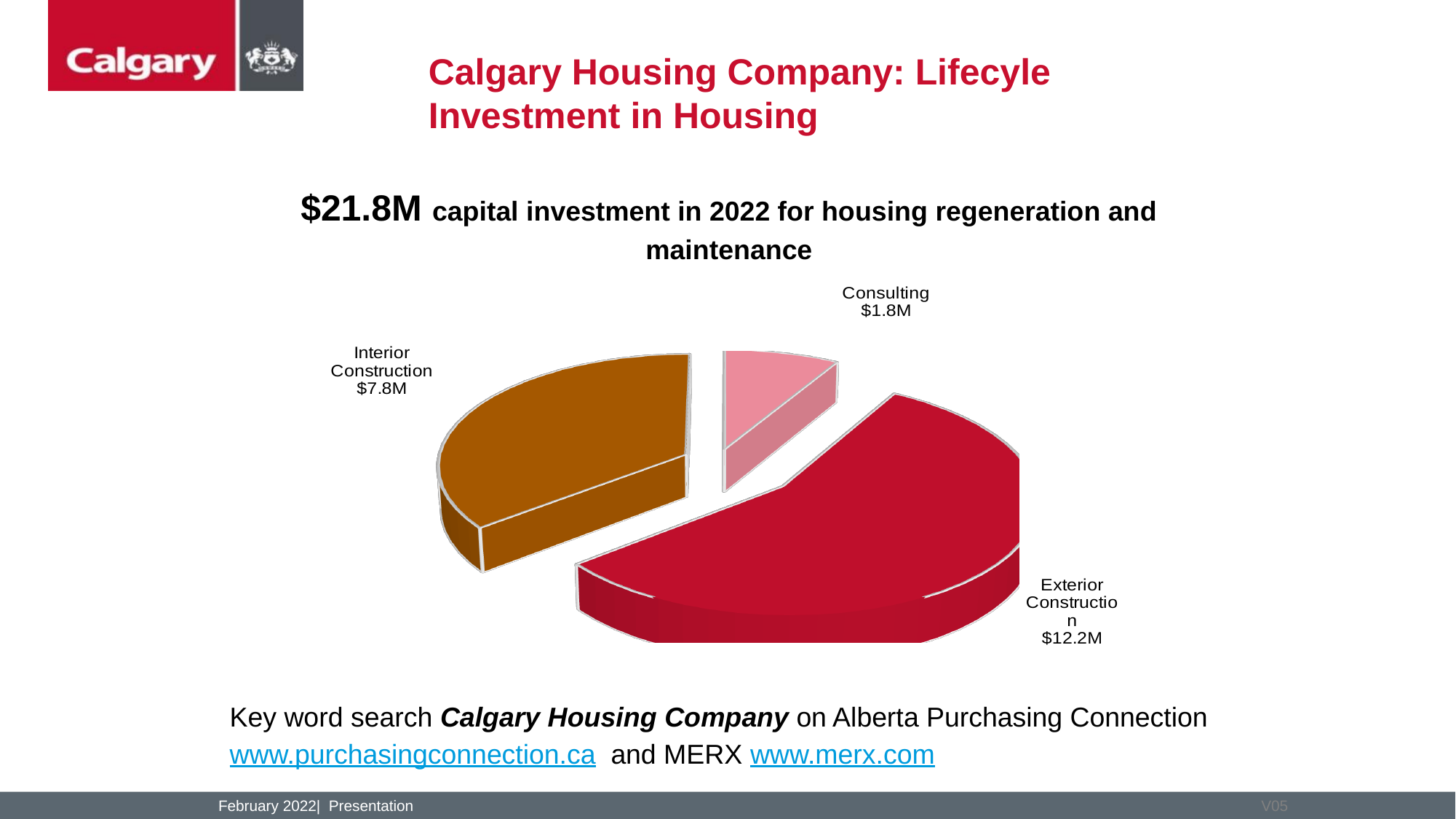
What is the total capital investment shown for 2022? $21.8M What is the difference between the Interior Construction and Consulting values? $6.0M What is the value of the Interior Construction slice? $7.8M How many slices does the pie chart have? 3 What colour is the Exterior Construction slice? Red What kind of chart is shown on the slide? Pie chart What is the value of the Exterior Construction slice? $12.2M Which category has the largest slice of the pie? Exterior Construction What is the difference between the Exterior Construction and Interior Construction values? $4.4M Which category has the smallest slice of the pie? Consulting Which is larger, Interior Construction or Consulting? Interior Construction What is the value of the Consulting slice? $1.8M